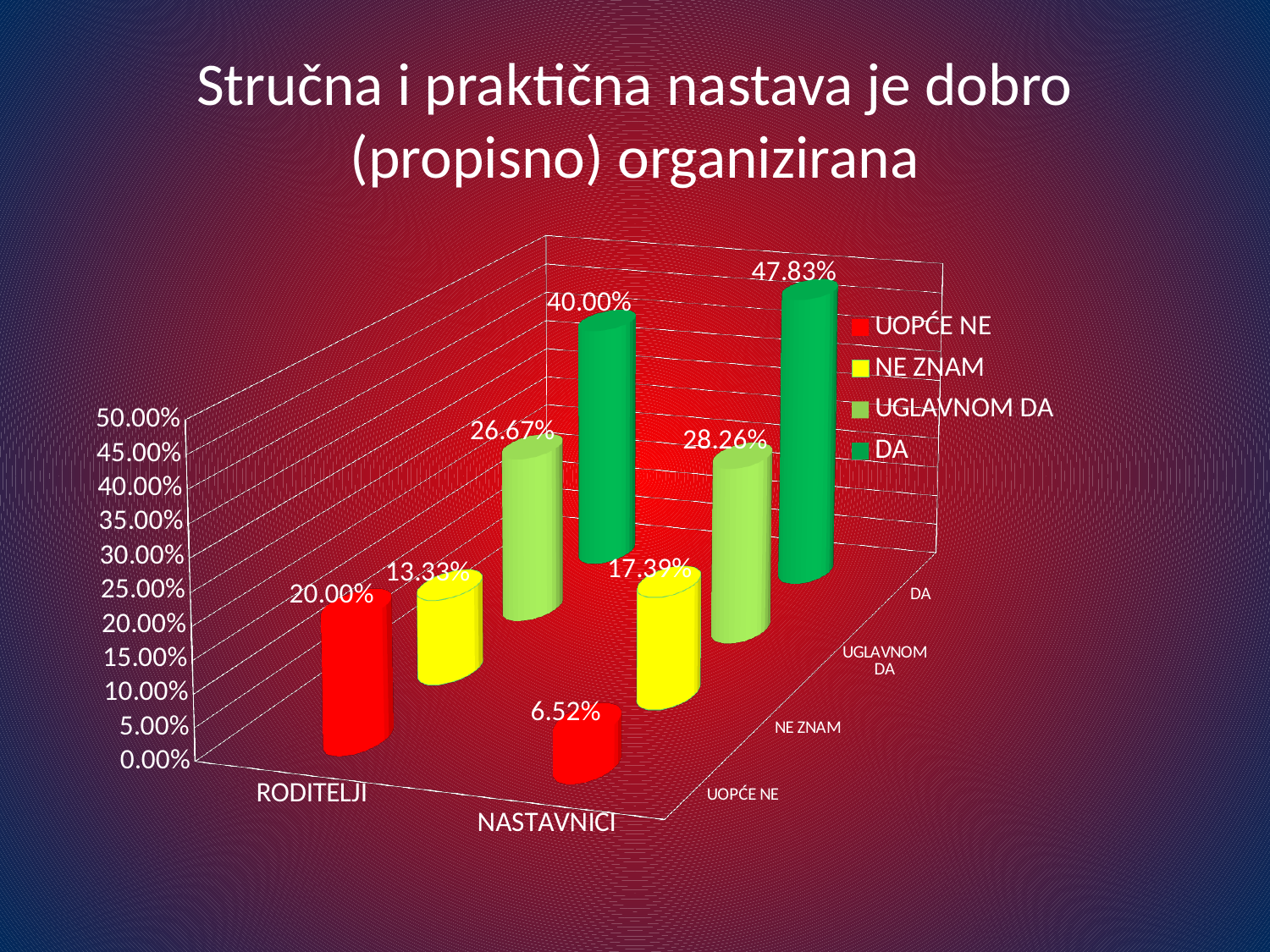
How many respondent groups are shown on the x axis? 2 What is the difference between the DA values for NASTAVNICI and RODITELJI? 7.83% What is the value for DA among NASTAVNICI? 47.83% What is the value for UOPĆE NE among RODITELJI? 20.00% What is the value for NE ZNAM among NASTAVNICI? 17.39% What colour represents the DA series in the legend? Green Which response has the highest value among NASTAVNICI? DA What is the value for UGLAVNOM DA among RODITELJI? 26.67% How many series does the legend list? 4 Which response has the lowest value among RODITELJI? NE ZNAM Which is larger: UOPĆE NE for RODITELJI or UOPĆE NE for NASTAVNICI? RODITELJI What kind of chart is shown on the slide? Bar chart